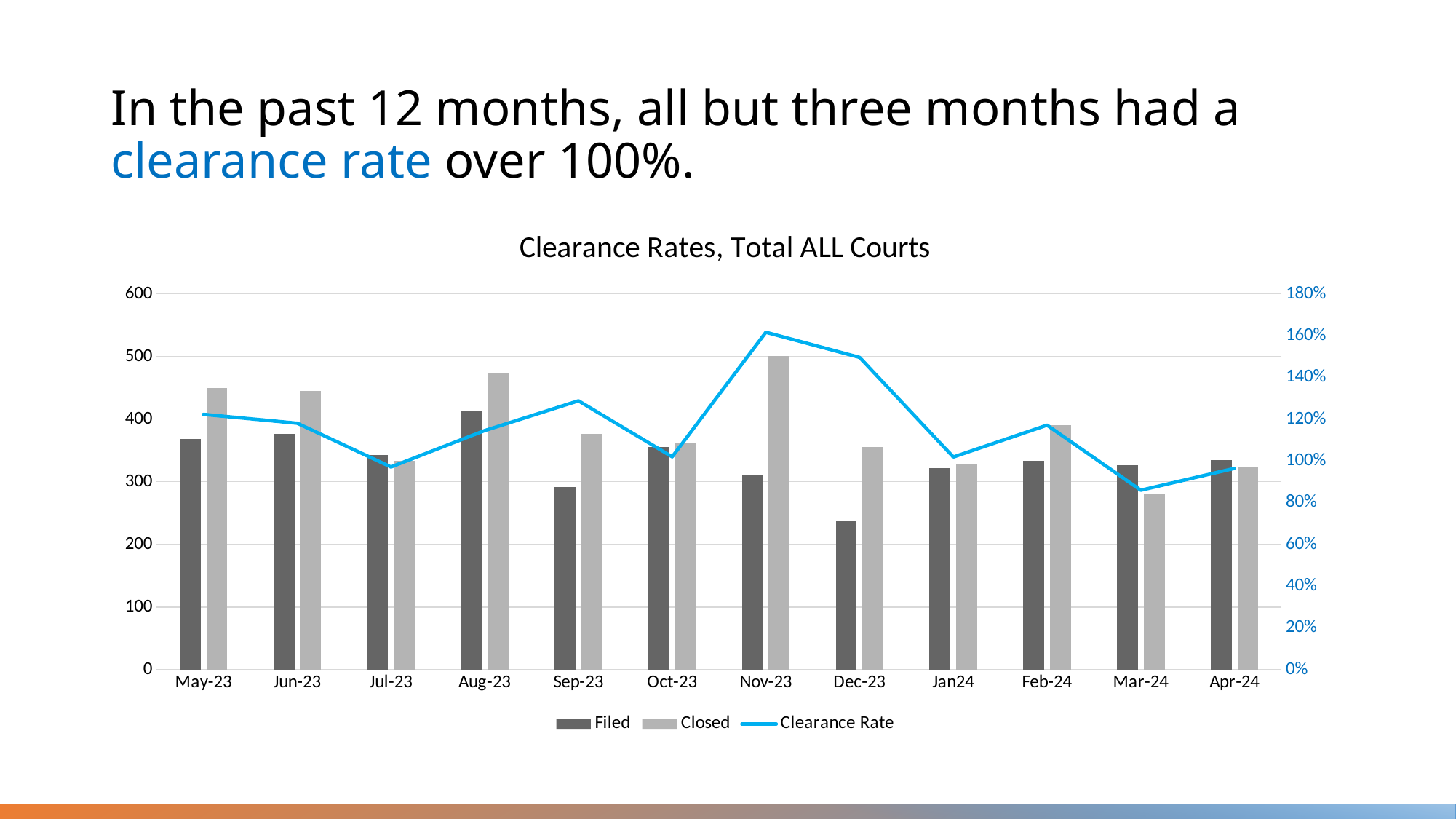
How many months are shown on the x axis of the chart? 12 In which month is the Clearance Rate line at its lowest? Mar-24 In which month is the Clearance Rate line at its highest? Nov-23 In Dec-23, which is larger, the Filed value or the Closed value? Closed What kind of chart is shown on the slide? A bar chart combined with a line Which month has the highest Closed value? Nov-23 Which month has the highest Filed value? Aug-23 How many series does the chart's legend list? 3 Which month has the lowest Filed value? Dec-23 Is the Filed value for Aug-23 greater or less than 400? greater What is the title of the chart? Clearance Rates, Total ALL Courts Is the Closed value for Mar-24 greater or less than 300? less